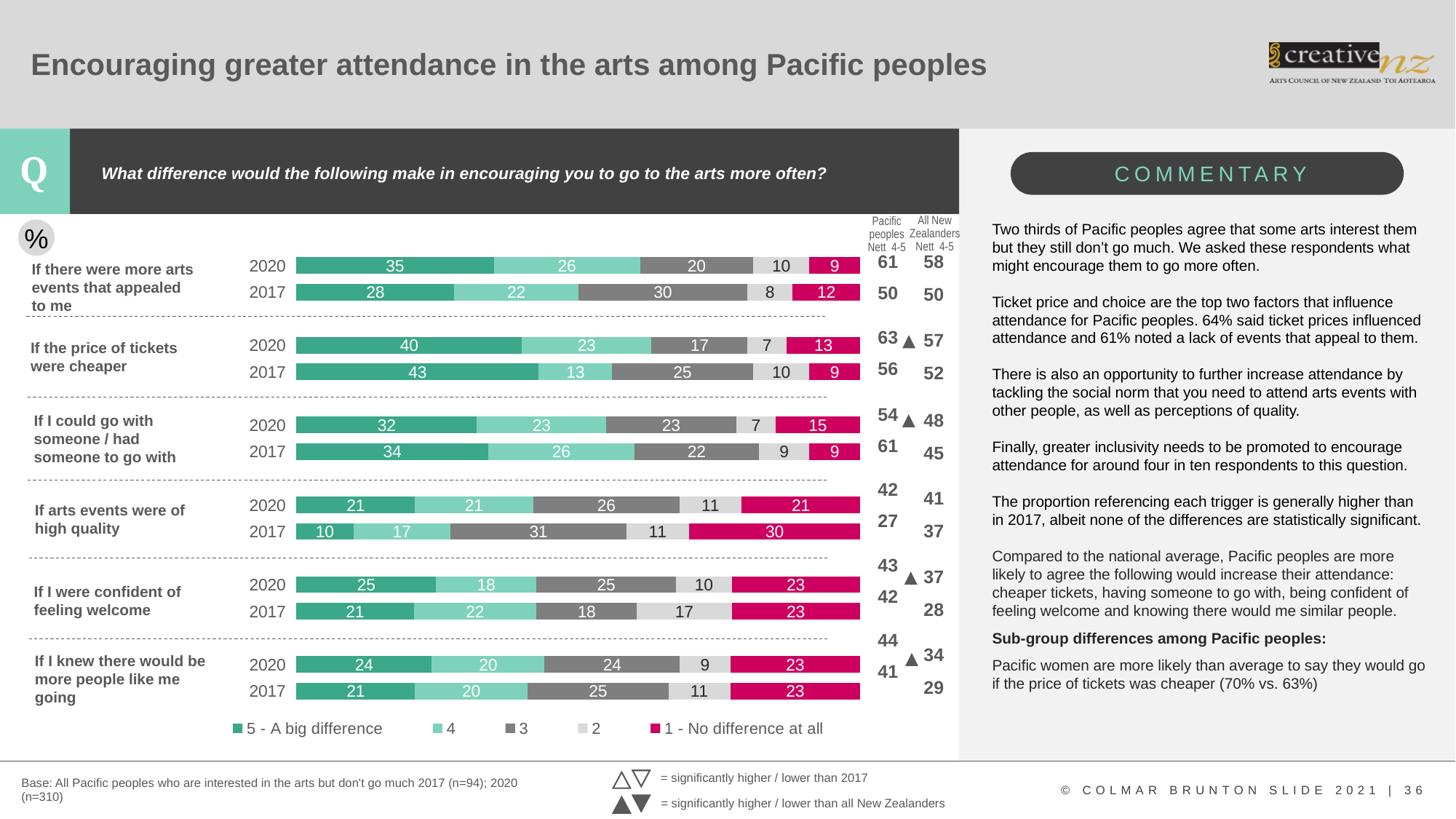
What is the value of the "3" segment for "If I knew there would be more people like me going" in 2020? 24 For "If there were more arts events that appealed to me", what is the difference between the 2020 and 2017 "5 - A big difference" values? 7 What is the Pacific peoples Nett 4-5 value for "If the price of tickets were cheaper" in 2020? 63 What kind of chart is shown on the slide? Stacked bar chart Which statement has the lowest "5 - A big difference" value in 2017? If arts events were of high quality How many series does the legend list? 5 What is the value of the "1 - No difference at all" segment for "If arts events were of high quality" in 2017? 30 What is the total of the printed segments in the 2020 bar for "If there were more arts events that appealed to me"? 100 What is the value of the "5 - A big difference" segment for "If the price of tickets were cheaper" in 2020? 40 For "If I could go with someone / had someone to go with", is the "1 - No difference at all" value larger in 2020 or 2017? 2020 Which statement has the highest "5 - A big difference" value in 2020? If the price of tickets were cheaper How many statements (categories) are shown in the chart? 6